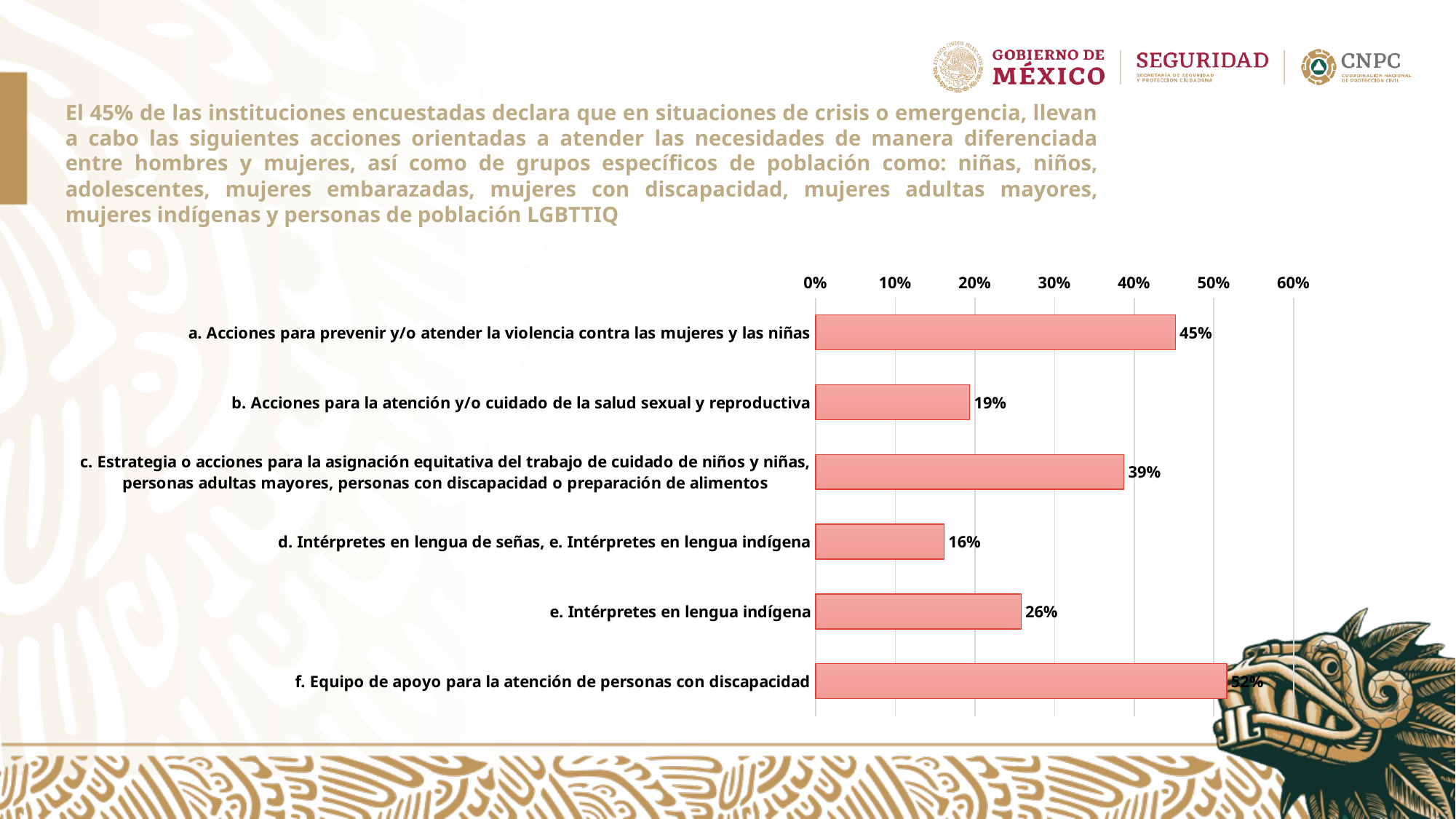
What is the value for 'f. Equipo de apoyo para la atención de personas con discapacidad'? 52% What kind of chart is shown on the slide? bar chart How many categories are shown in the chart? 6 Is the value for 'c. Estrategia o acciones para la asignación equitativa del trabajo de cuidado...' greater or less than 30%? greater What is the value for 'b. Acciones para la atención y/o cuidado de la salud sexual y reproductiva'? 19% What is the maximum value shown on the percentage axis? 60% What is the value for 'a. Acciones para prevenir y/o atender la violencia contra las mujeres y las niñas'? 45% Which is larger: the value for 'c. Estrategia o acciones para la asignación equitativa del trabajo de cuidado...' or the value for 'e. Intérpretes en lengua indígena'? c. Estrategia o acciones para la asignación equitativa del trabajo de cuidado... What is the difference between the value for 'f. Equipo de apoyo para la atención de personas con discapacidad' and the value for 'a. Acciones para prevenir y/o atender la violencia contra las mujeres y las niñas'? 7% What is the value for 'e. Intérpretes en lengua indígena'? 26% Which category has the highest value? f. Equipo de apoyo para la atención de personas con discapacidad Which category has the lowest value? d. Intérpretes en lengua de señas, e. Intérpretes en lengua indígena